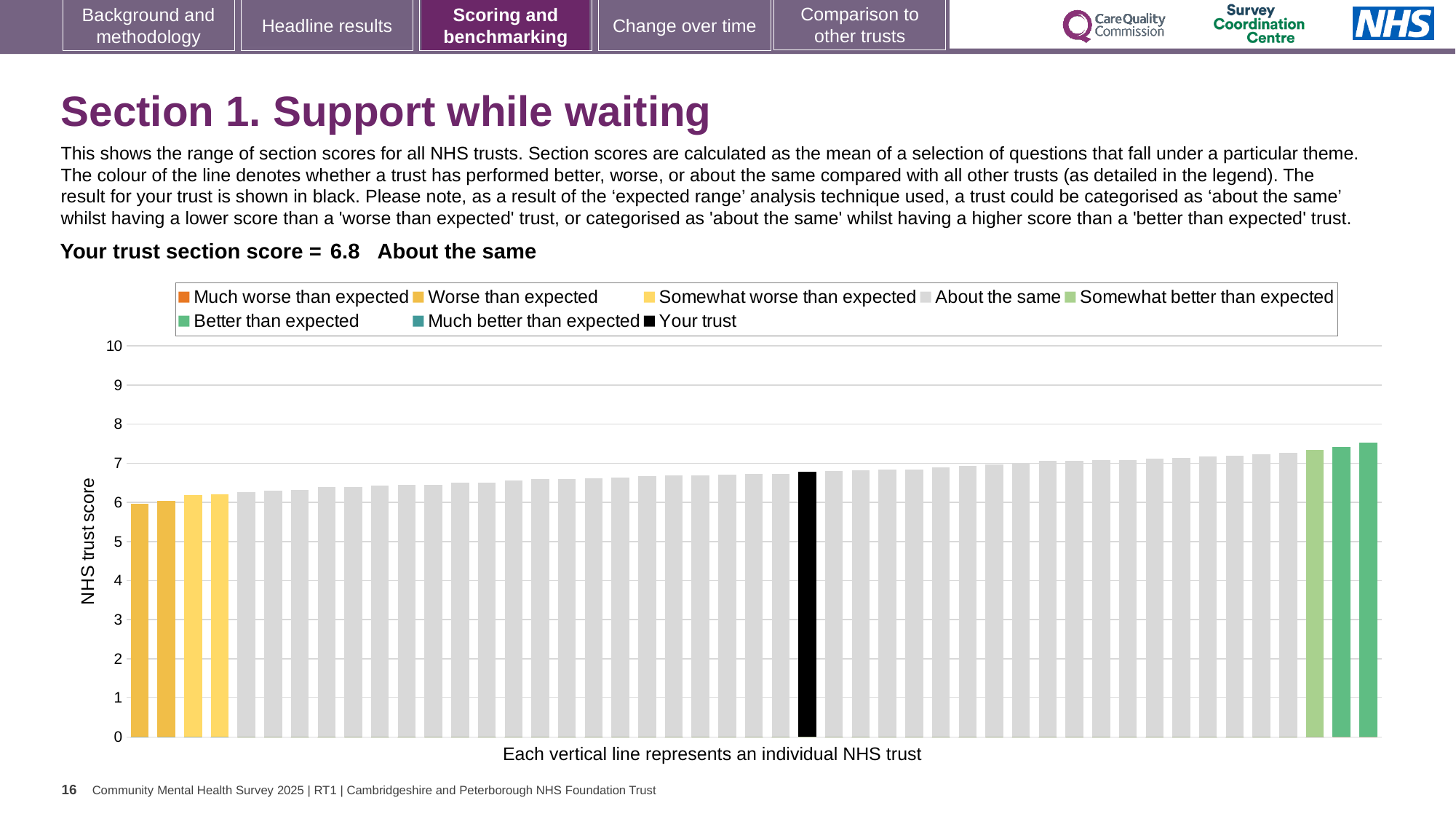
What is the label on the y axis of the chart? NHS trust score What is the section score for your trust shown on the slide? 6.8 Do the bar values rise or fall from left to right along the x axis? rise Is the value of the shortest bar (leftmost) greater or less than 7? less How many entries does the chart legend list? 8 What colour is used for the 'Your trust' bar in the chart? black Is the value of the leftmost bar greater or less than 5? greater How many bars are coloured green (better than expected categories) in the chart? 3 Is the value of the tallest bar (rightmost) greater or less than 7? greater Which bar is higher: the black 'Your trust' bar or the leftmost bar? the black 'Your trust' bar What kind of chart is shown on the slide? bar chart